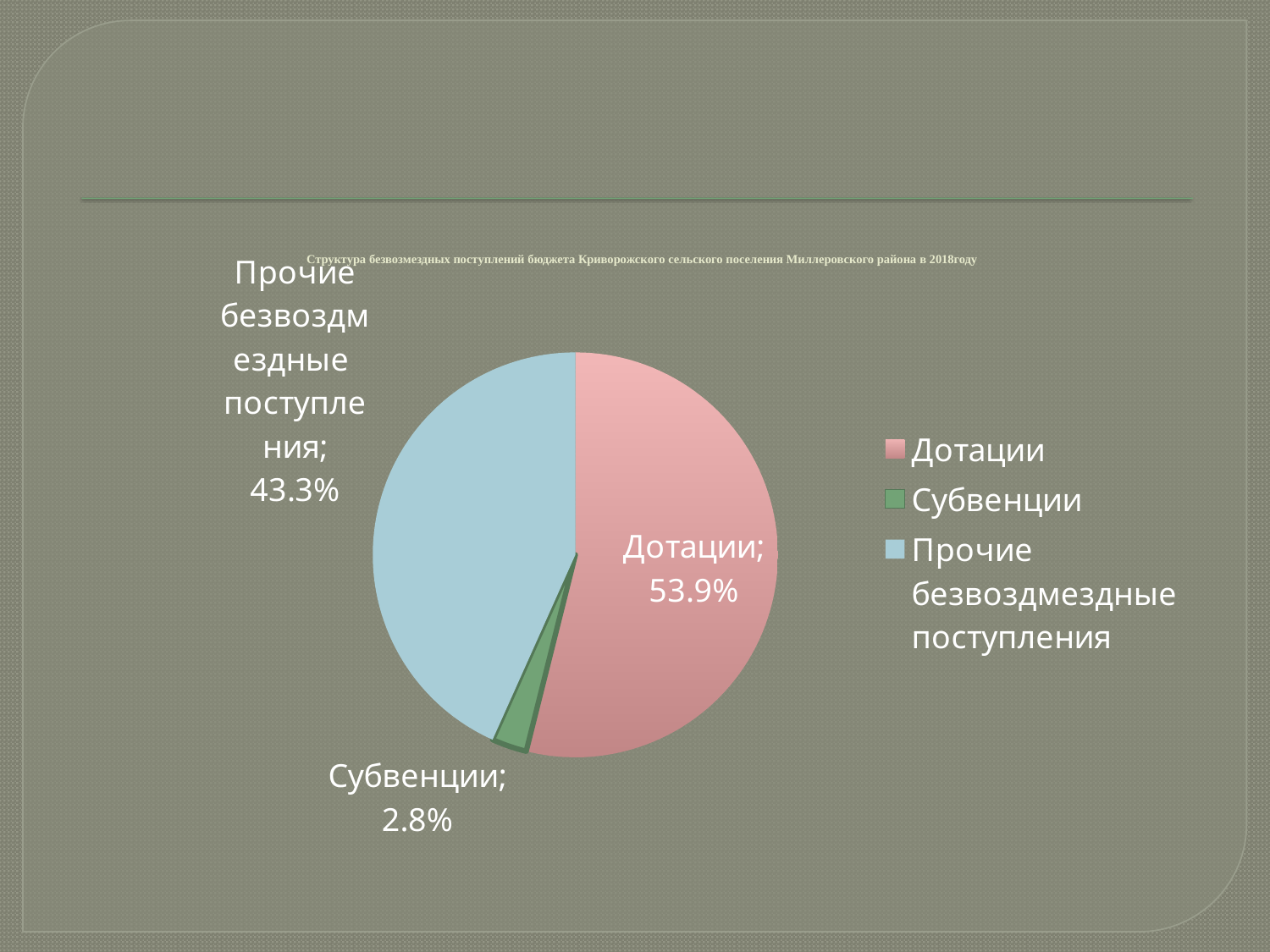
Which is larger, the share for Дотации or the share for Прочие безвоздмездные поступления? Дотации How many slices does the pie chart have? 3 How many entries does the legend list? 3 What is the difference in percentage points between the Прочие безвоздмездные поступления share and the Субвенции share? 40.5 Which category has the smallest slice of the pie? Субвенции Which category has the largest slice of the pie? Дотации What share of the pie does Субвенции have? 2.8% What share of the pie does Дотации have? 53.9% What colour is the Субвенции slice in the pie chart? Green What is the difference in percentage points between the Дотации share and the Прочие безвоздмездные поступления share? 10.6 What share of the pie does Прочие безвоздмездные поступления have? 43.3% What kind of chart is shown on the slide? Pie chart